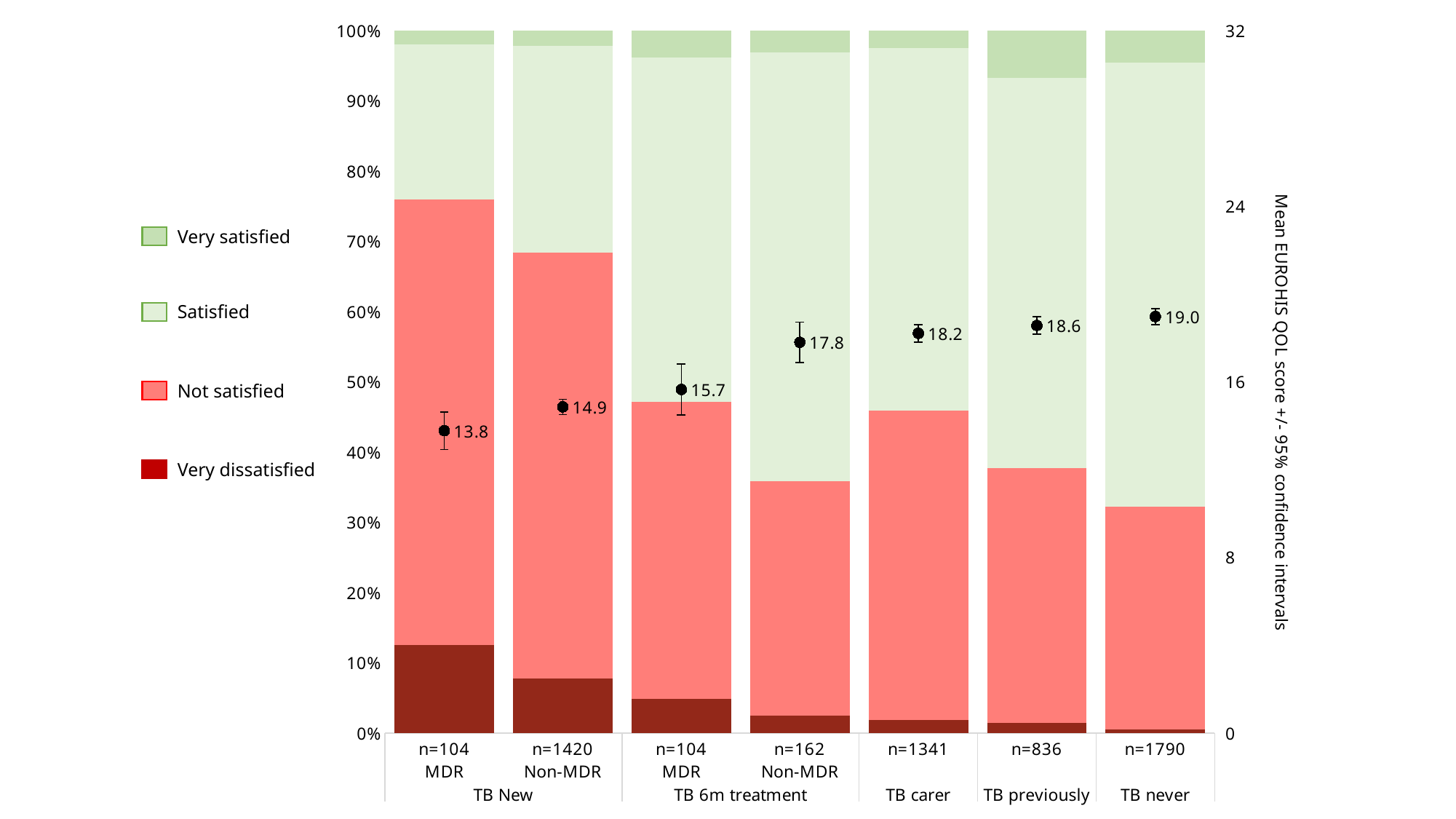
What is the mean EUROHIS QOL score for the TB New MDR group? 13.8 Is the combined share of Not satisfied and Very dissatisfied for the TB New MDR group greater or less than 70%? greater What is the mean EUROHIS QOL score for the TB 6m treatment Non-MDR group? 17.8 What is the difference between the mean EUROHIS QOL scores of the TB never group and the TB New MDR group? 5.2 Which group has the lowest mean EUROHIS QOL score? TB New MDR Which has a higher mean EUROHIS QOL score, TB carer or TB previously? TB previously What is the mean EUROHIS QOL score for the TB never group? 19.0 Do the mean EUROHIS QOL scores rise or fall from left to right across the groups? rise How many satisfaction categories does the legend list? 4 Which group has the highest mean EUROHIS QOL score? TB never Is the combined share of Not satisfied and Very dissatisfied for the TB never group greater or less than 40%? less How many bars are shown in the chart? 7